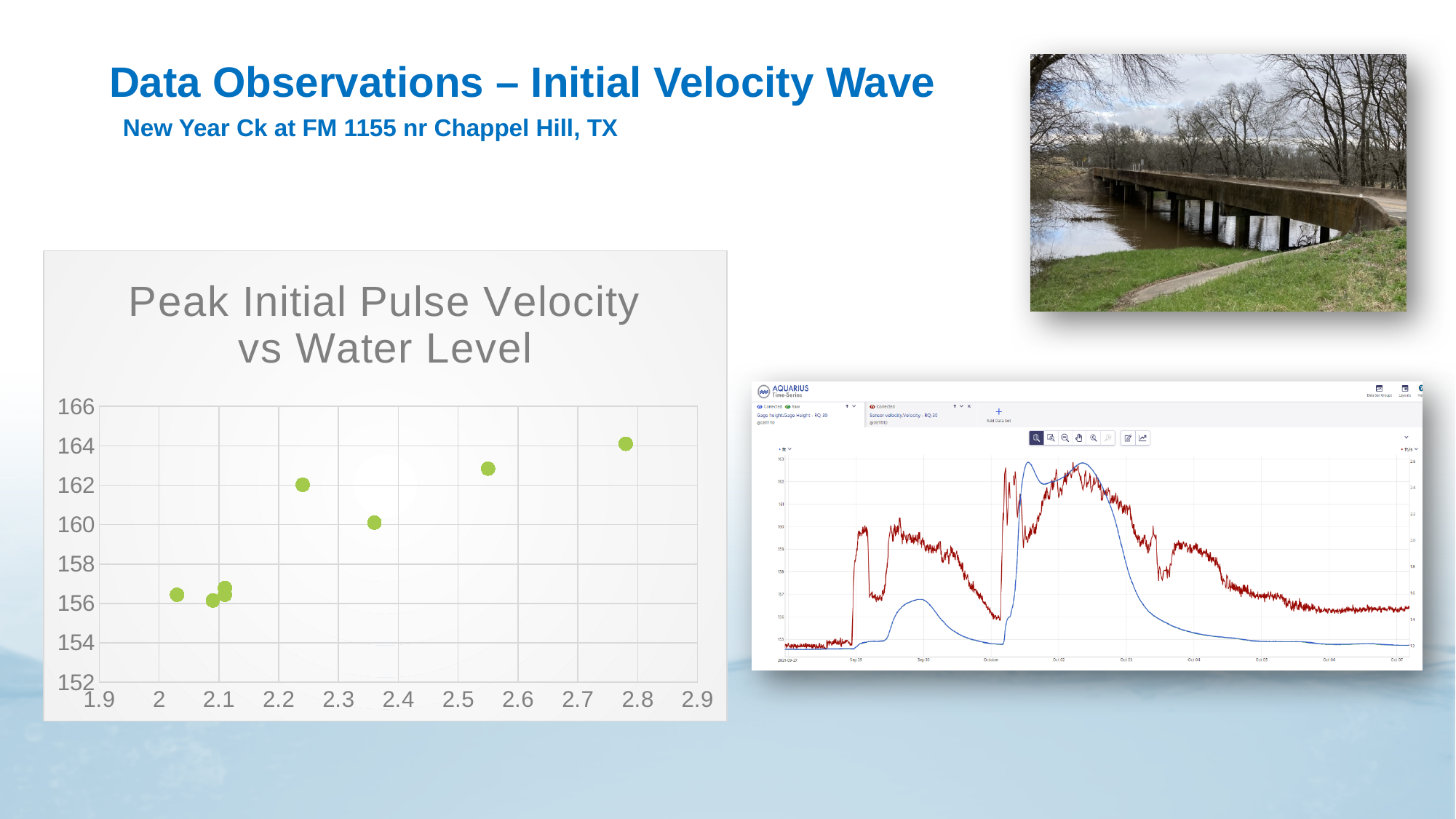
In the 'Peak Initial Pulse Velocity vs Water Level' chart, which point has the highest y value: the one near x = 2.78 or the one near x = 2.55? the one near x = 2.78 In the 'Peak Initial Pulse Velocity vs Water Level' chart, do the values generally rise or fall as the x-axis value increases? rise In the 'Peak Initial Pulse Velocity vs Water Level' chart, is the y value of the point near x = 2.78 greater or less than 162? greater In the 'Peak Initial Pulse Velocity vs Water Level' chart, is the y value of the point near x = 2.03 greater or less than 158? less How many data points are plotted in the 'Peak Initial Pulse Velocity vs Water Level' chart? 8 In the 'Peak Initial Pulse Velocity vs Water Level' chart, is the y value of the point near x = 2.55 greater or less than 162? greater What kind of chart is 'Peak Initial Pulse Velocity vs Water Level'? scatter chart How many line series are plotted in the AQUARIUS Time-Series chart on the right of the slide? 2 In the 'Peak Initial Pulse Velocity vs Water Level' chart, which point has a higher y value: the one near x = 2.24 or the one near x = 2.36? the one near x = 2.24 What is the lowest value shown on the y axis of the 'Peak Initial Pulse Velocity vs Water Level' chart? 152 What is the title of the scatter chart on the left of the slide? Peak Initial Pulse Velocity vs Water Level